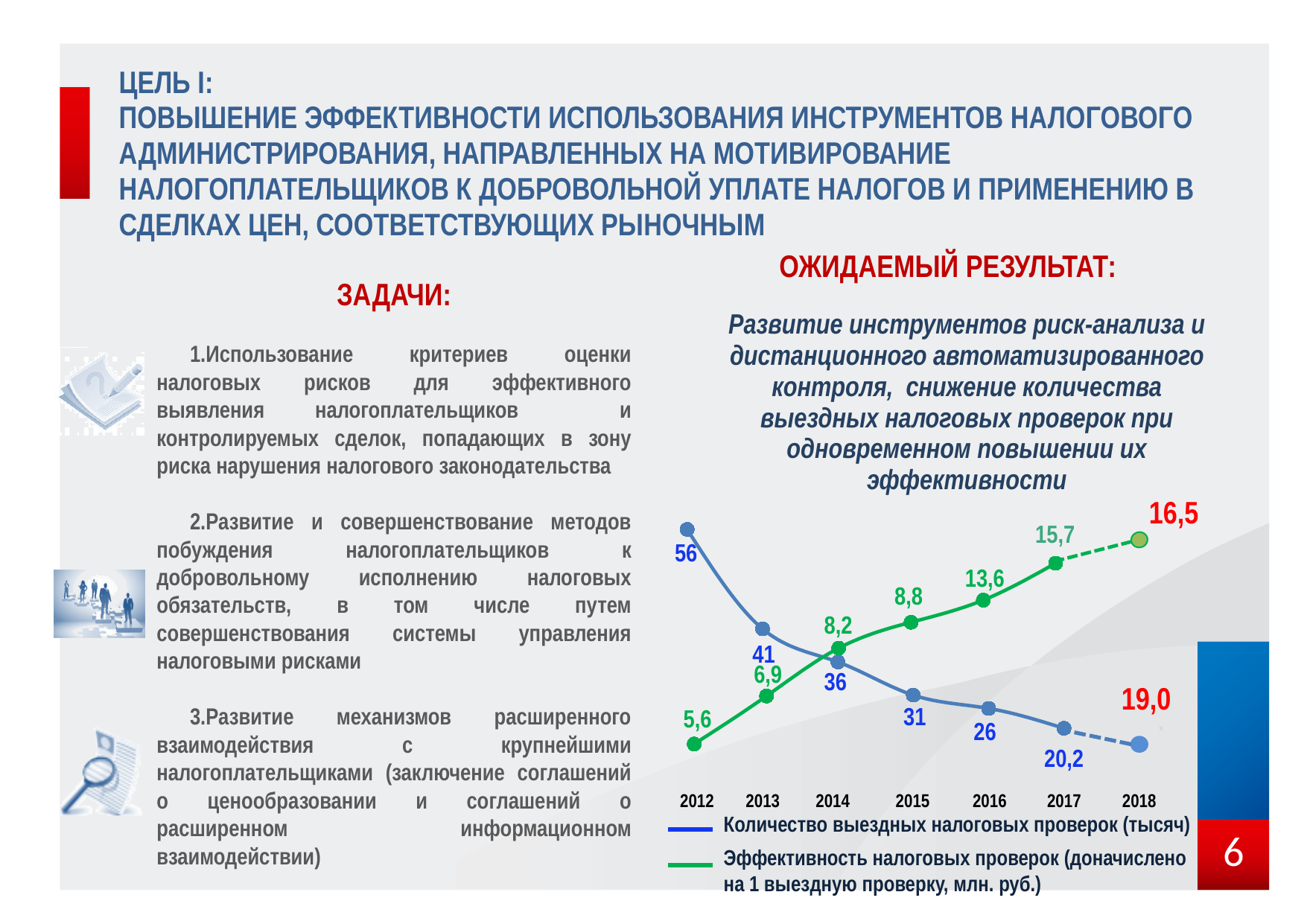
What type of chart is shown on the slide? line chart Does 'Эффективность налоговых проверок' rise or fall from 2012 to 2018? rise What is the difference between the 'Количество выездных налоговых проверок (тысяч)' values in 2012 and 2018? 37 What is the value of 'Эффективность налоговых проверок' in 2018? 16,5 Which is larger in 2014: 'Количество выездных налоговых проверок (тысяч)' or 'Эффективность налоговых проверок'? Количество выездных налоговых проверок (тысяч) How many series does the chart legend list? 2 In which year is 'Эффективность налоговых проверок' lowest? 2012 What is the value of 'Количество выездных налоговых проверок (тысяч)' in 2012? 56 In which year is 'Количество выездных налоговых проверок (тысяч)' highest? 2012 What is the value of 'Количество выездных налоговых проверок (тысяч)' in 2017? 20,2 What colour is the line for 'Эффективность налоговых проверок'? green How many years are shown on the x axis of the chart? 7